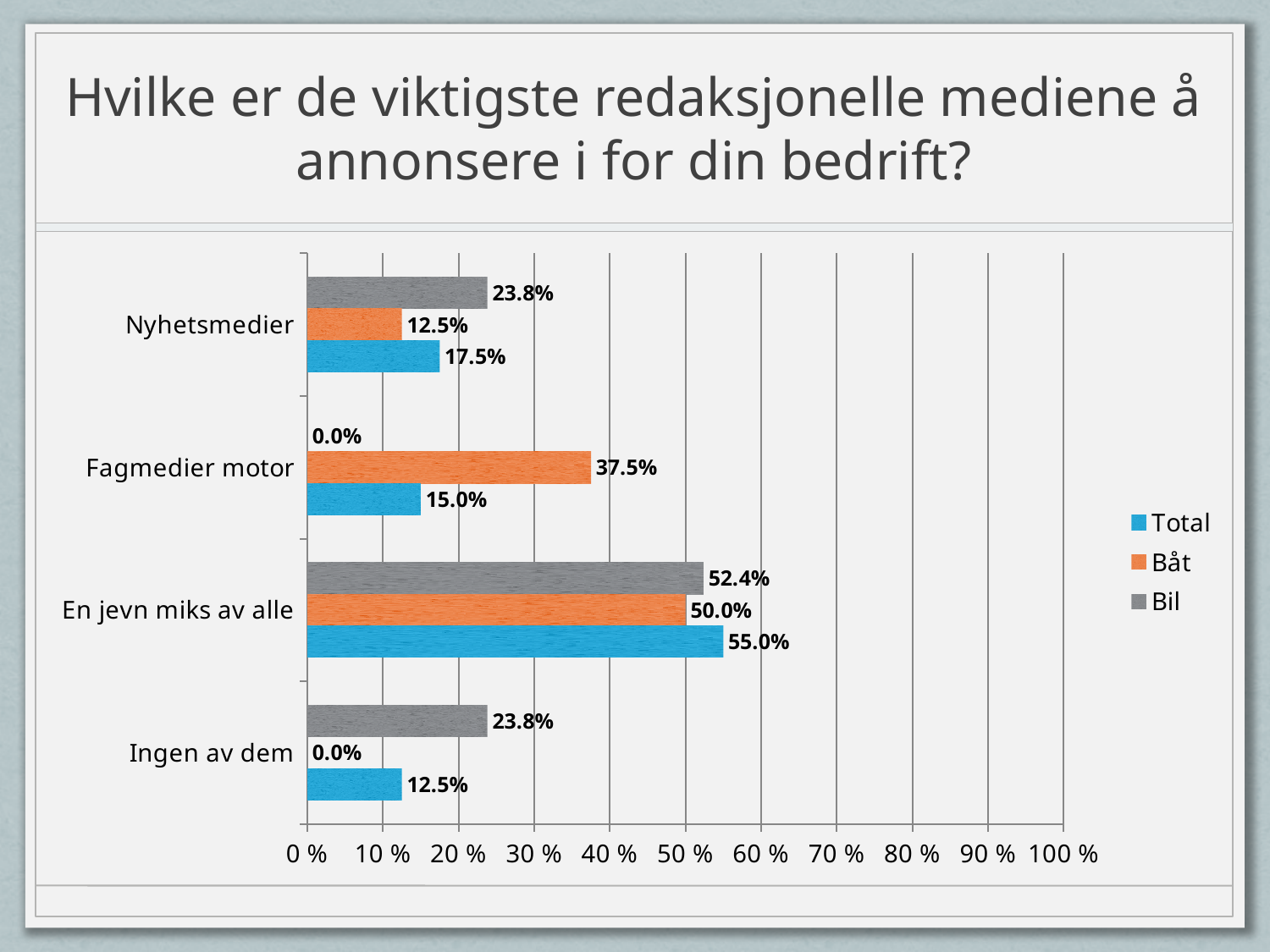
How many series does the legend list? 3 Which series is shown in orange in the legend? Båt Which category has the highest Total value? En jevn miks av alle What is the Båt value for Fagmedier motor? 37.5% What is the difference between the Total and Båt values for En jevn miks av alle? 5.0% Which category has the lowest Total value? Ingen av dem How many categories are shown on the chart? 4 What is the Båt value for Nyhetsmedier? 12.5% What kind of chart is shown on the slide? Bar chart What is the Total value for En jevn miks av alle? 55.0% For Nyhetsmedier, which is larger: the Bil value or the Total value? Bil What is the Bil value for Ingen av dem? 23.8%